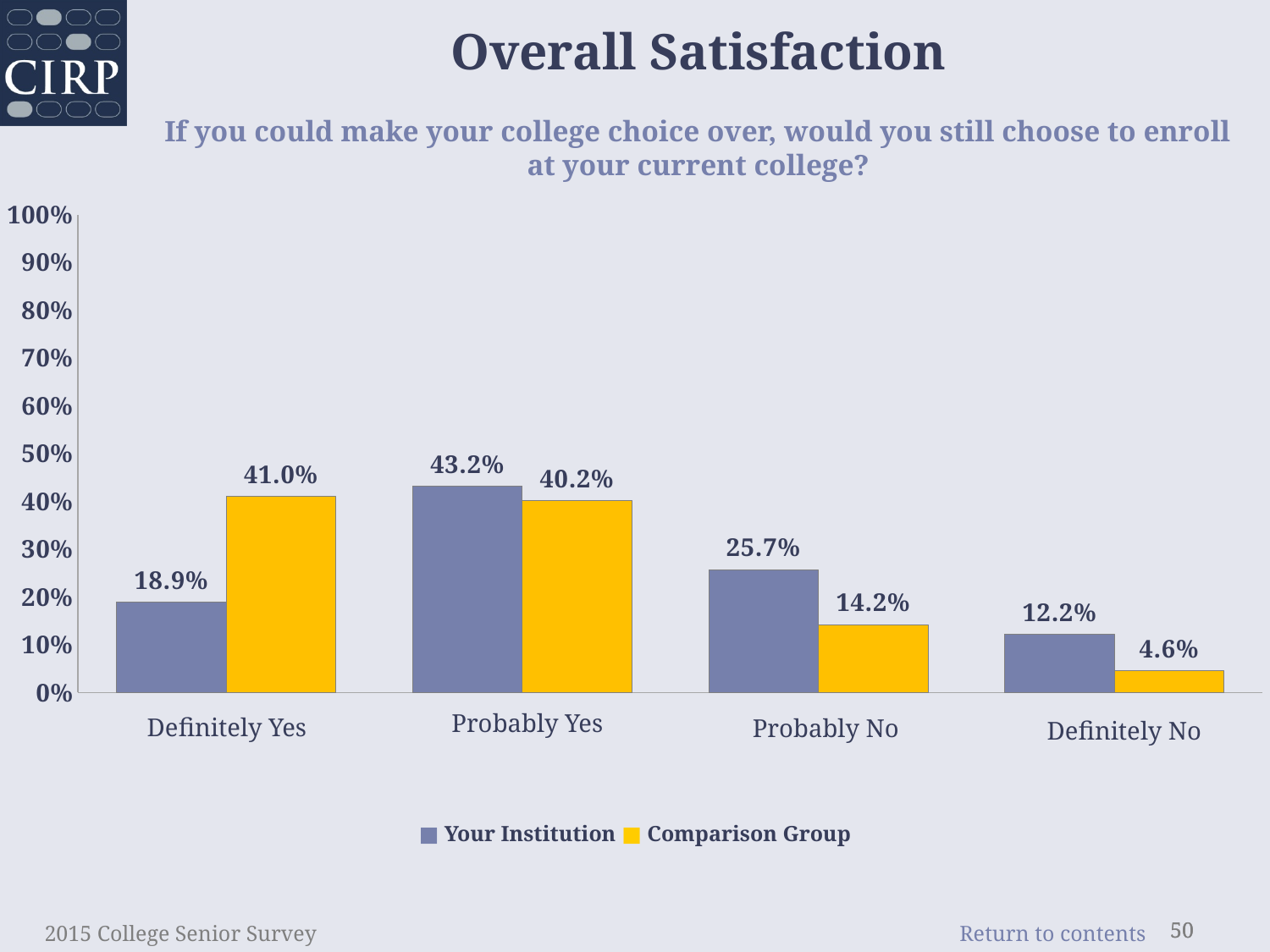
What is the difference between Comparison Group and Your Institution in the Definitely Yes category? 22.1% In the Definitely Yes category, which series has the larger value, Your Institution or Comparison Group? Comparison Group Is the value for Your Institution in the Probably Yes category greater or less than 40%? greater What is the value for Comparison Group in the Definitely No category? 4.6% What is the value for Comparison Group in the Probably No category? 14.2% What is the difference between Your Institution and Comparison Group in the Probably No category? 11.5% Which category has the lowest value for Comparison Group? Definitely No How many categories are shown on the x axis? 4 How many series does the legend list? 2 Which category has the highest value for Your Institution? Probably Yes What is the value for Your Institution in the Definitely Yes category? 18.9% What kind of chart is shown on the slide? Bar chart